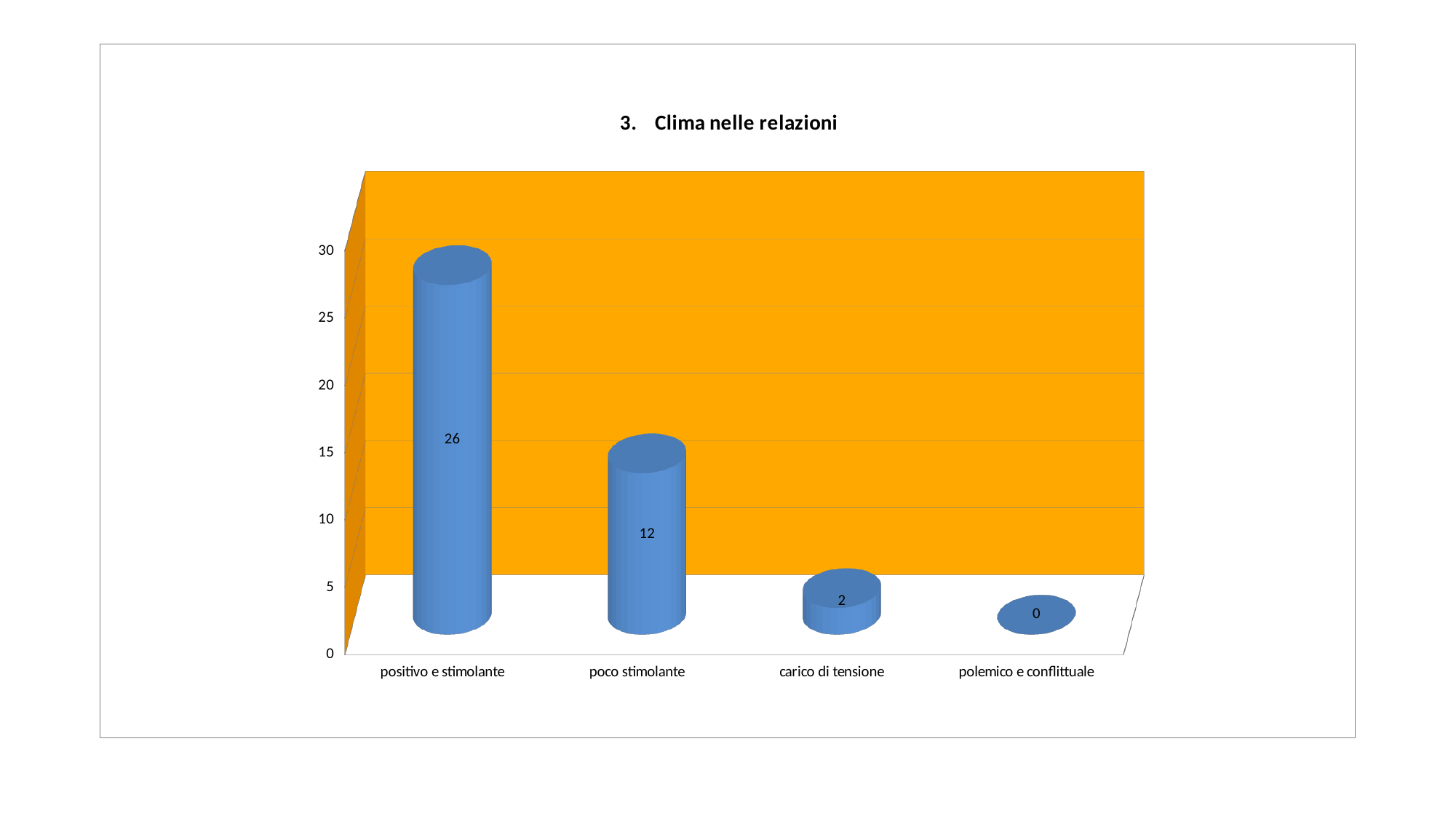
Which is larger, the value for "poco stimolante" or the value for "carico di tensione"? poco stimolante Which category has the highest value? positivo e stimolante What is the value for "polemico e conflittuale"? 0 What is the value for "poco stimolante"? 12 How many categories are shown on the x axis? 4 What is the value for "positivo e stimolante"? 26 What is the title of the chart? 3. Clima nelle relazioni Which category has the lowest value? polemico e conflittuale What kind of chart is shown on the slide? bar chart What is the difference between the values for "positivo e stimolante" and "poco stimolante"? 14 What is the value for "carico di tensione"? 2 Do the values rise or fall from left to right along the x axis? fall